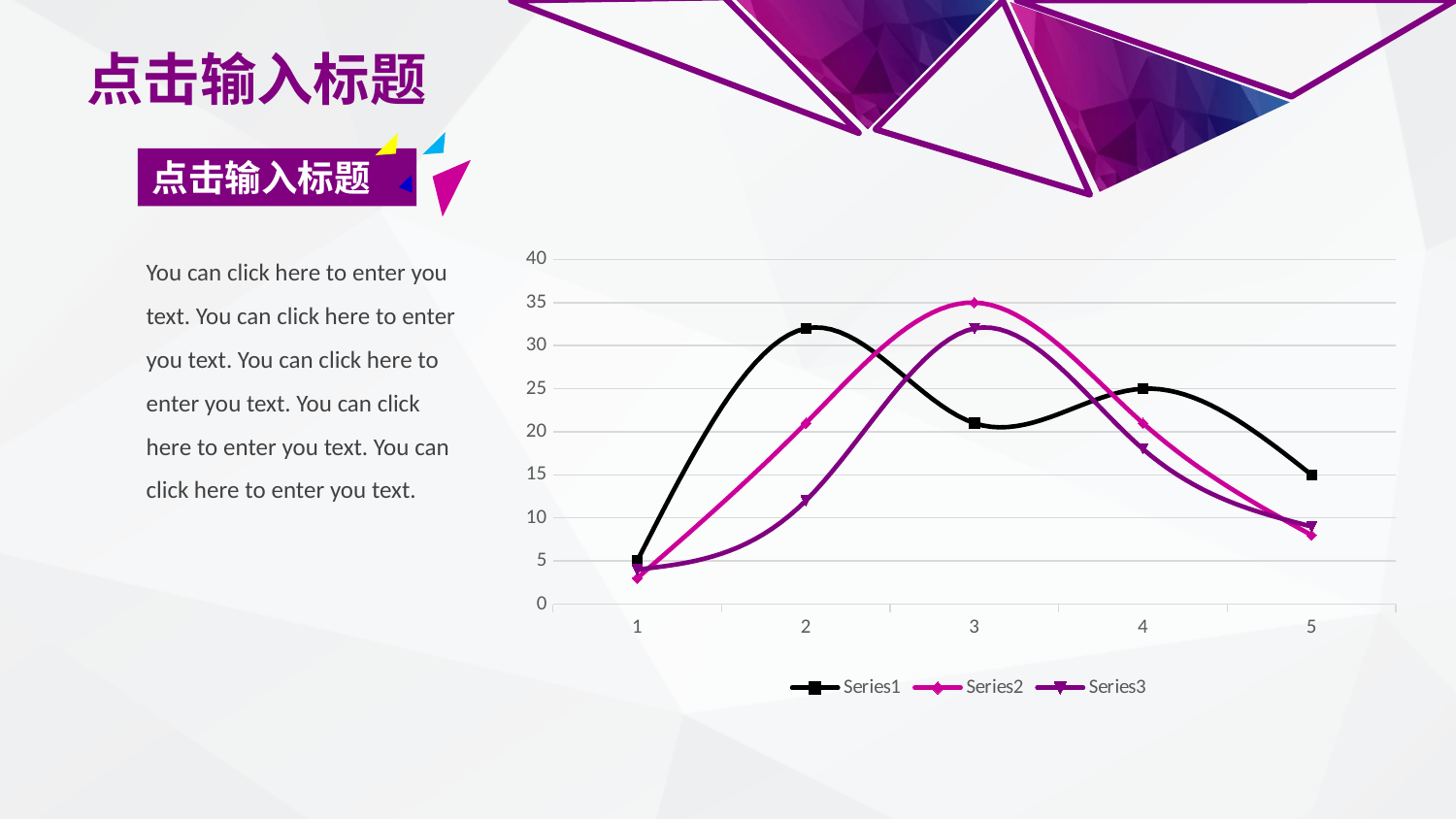
At category 3, which is larger: Series1 or Series2? Series2 At which x-axis category does Series2 reach its highest value? 3 At which x-axis category does Series1 reach its highest value? 2 What colour is the line for Series1? black What is the value of Series2 at category 3? 35 Is the value for Series3 at category 2 greater or less than 15? less At category 2, which is larger: Series1 or Series3? Series1 Is the value for Series1 at category 2 greater or less than 30? greater How many points are plotted along the x axis for each series? 5 At which x-axis category is Series1 at its lowest value? 1 What kind of chart is shown on the slide? line chart How many series does the legend list? 3